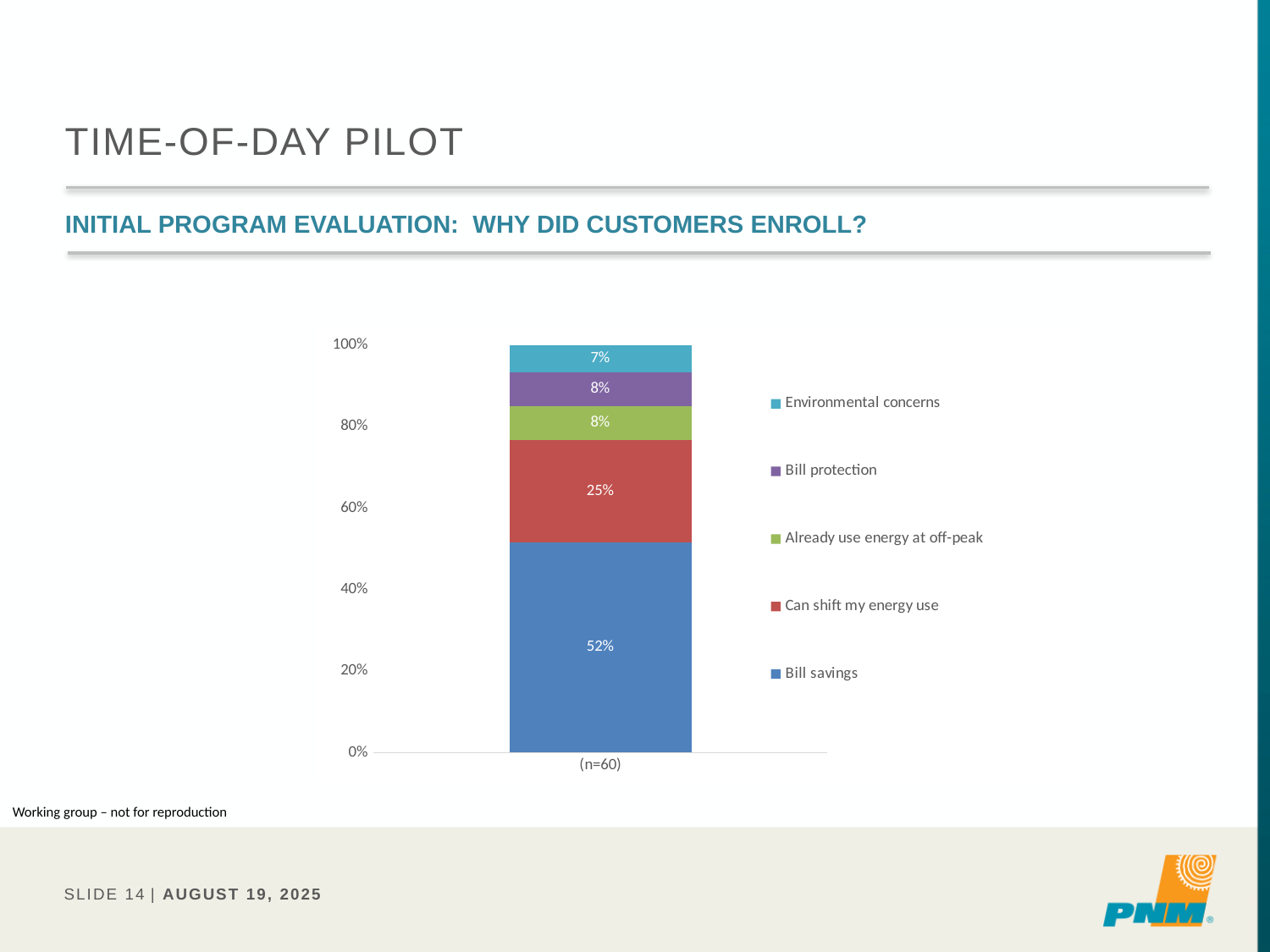
How many series does the legend list? 5 Which reason for enrolling has the largest share? Bill savings What percentage of customers enrolled because they can shift their energy use? 25% Which is larger, the share for Bill protection or the share for Environmental concerns? Bill protection Which reason for enrolling has the smallest share? Environmental concerns What is the sample size shown on the x axis label? n=60 What is the total of the stacked bar? 100% What percentage of customers enrolled due to Environmental concerns? 7% What kind of chart is shown on the slide? Stacked bar chart What is the difference between the Bill savings share and the Can shift my energy use share? 27% What percentage of customers enrolled for Bill protection? 8% What percentage of customers enrolled for Bill savings? 52%